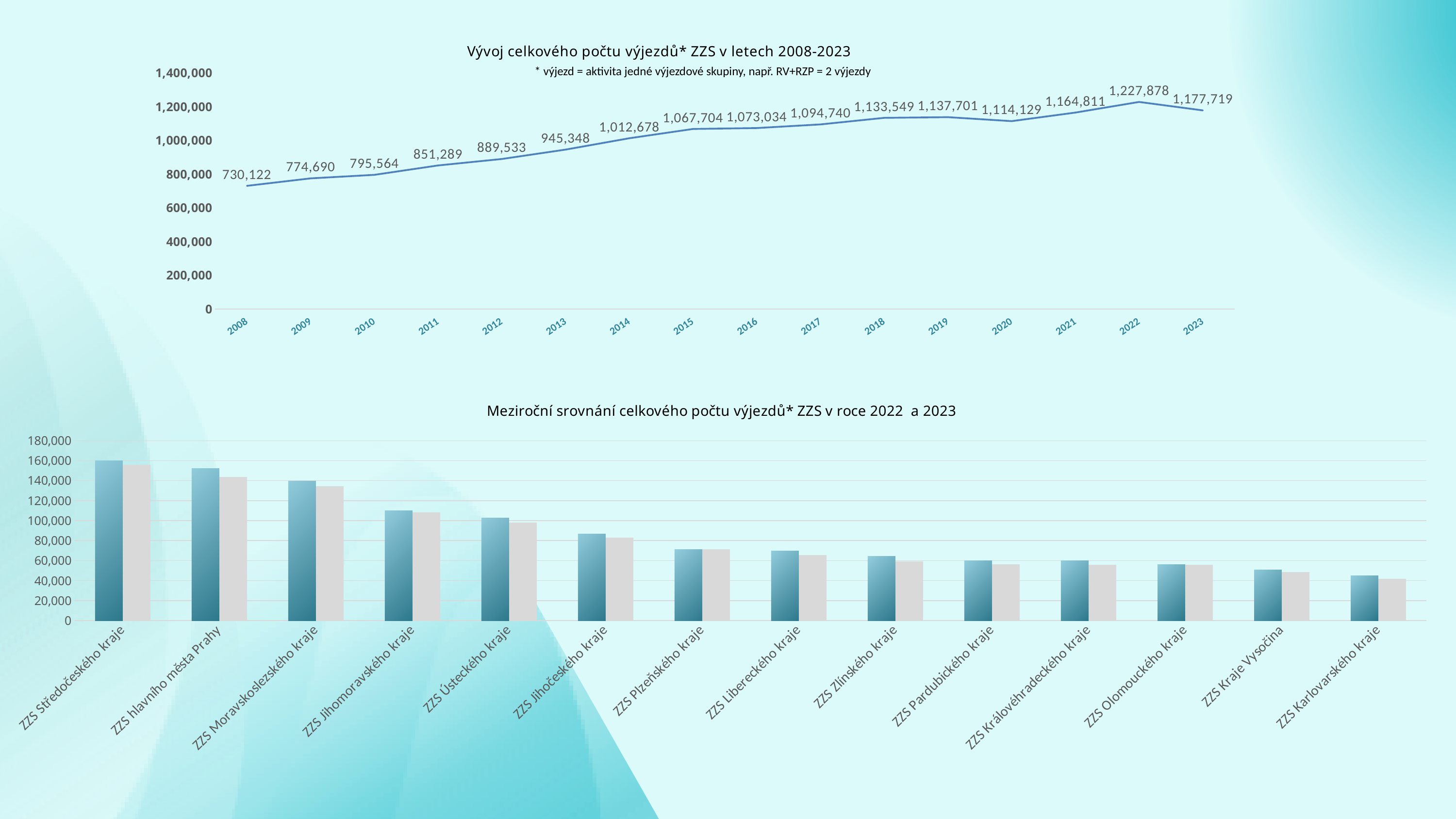
In the top chart 'Vývoj celkového počtu výjezdů* ZZS v letech 2008-2023', what is the value for 2008? 730,122 What kind of chart is the top chart 'Vývoj celkového počtu výjezdů* ZZS v letech 2008-2023'? line chart In the top chart 'Vývoj celkového počtu výjezdů* ZZS v letech 2008-2023', which year has the highest value? 2022 In the top chart 'Vývoj celkového počtu výjezdů* ZZS v letech 2008-2023', which year has the lowest value? 2008 In the bottom chart 'Meziroční srovnání celkového počtu výjezdů* ZZS v roce 2022 a 2023', which region has the highest values? ZZS Středočeského kraje In the top chart 'Vývoj celkového počtu výjezdů* ZZS v letech 2008-2023', what is the difference between the values for 2022 and 2023? 50,159 In the top chart 'Vývoj celkového počtu výjezdů* ZZS v letech 2008-2023', do the values generally rise or fall from 2008 to 2023? rise In the top chart 'Vývoj celkového počtu výjezdů* ZZS v letech 2008-2023', how many years are plotted? 16 In the top chart 'Vývoj celkového počtu výjezdů* ZZS v letech 2008-2023', which is larger, the value for 2019 or the value for 2020? 2019 In the bottom chart 'Meziroční srovnání celkového počtu výjezdů* ZZS v roce 2022 a 2023', is the value of the first (dark) bar for ZZS Karlovarského kraje greater or less than 60,000? less In the top chart 'Vývoj celkového počtu výjezdů* ZZS v letech 2008-2023', what is the value for 2023? 1,177,719 In the bottom chart 'Meziroční srovnání celkového počtu výjezdů* ZZS v roce 2022 a 2023', how many regions are shown on the x axis? 14